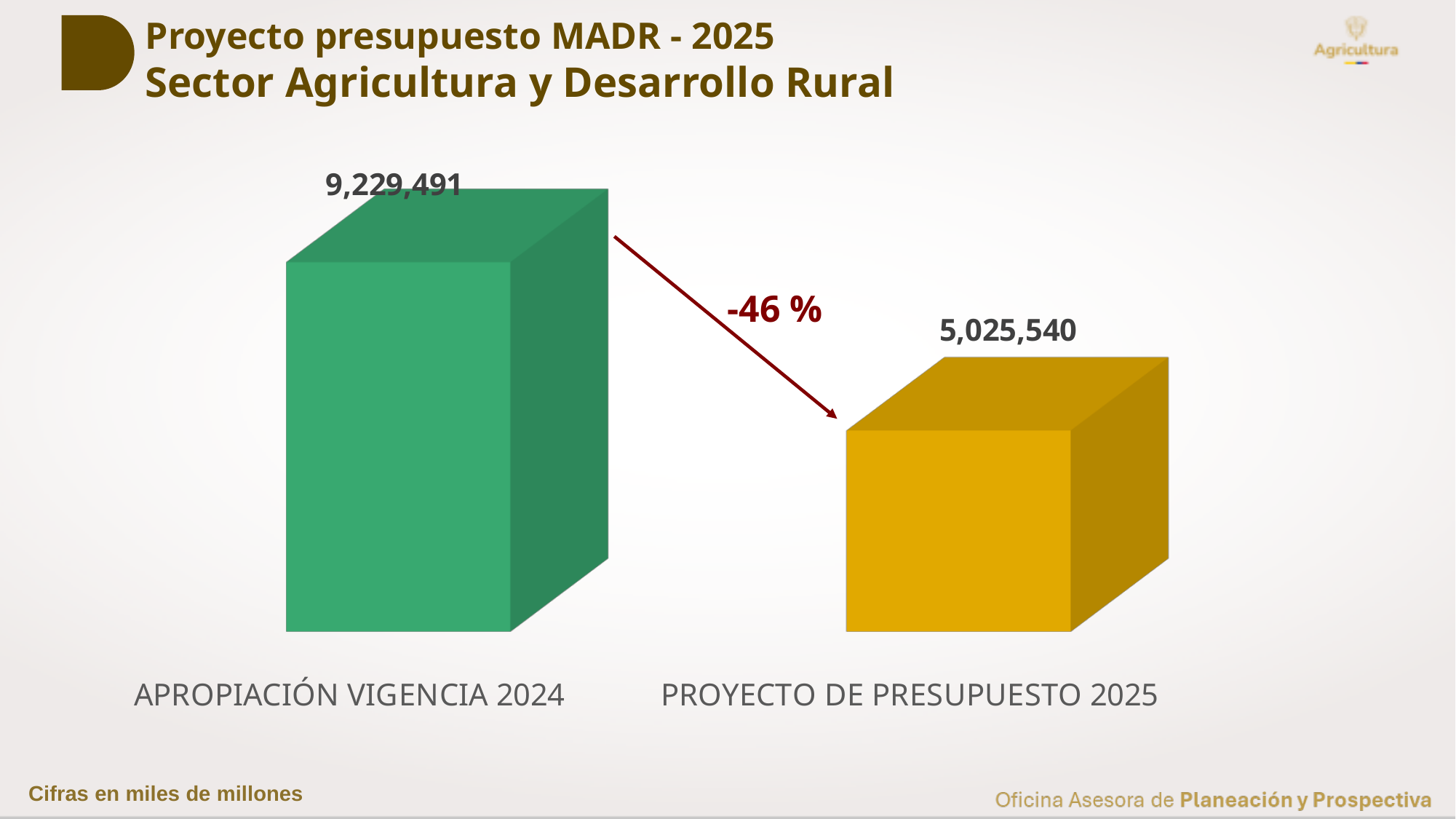
Which category has the highest value? APROPIACIÓN VIGENCIA 2024 Do the values rise or fall from APROPIACIÓN VIGENCIA 2024 to PROYECTO DE PRESUPUESTO 2025? Fall What percentage change is annotated on the arrow between the two bars? -46 % How many categories are shown in the chart? 2 What colour is the bar for PROYECTO DE PRESUPUESTO 2025? Yellow What is the difference between the value for APROPIACIÓN VIGENCIA 2024 and the value for PROYECTO DE PRESUPUESTO 2025? 4,203,951 What is the value for PROYECTO DE PRESUPUESTO 2025? 5,025,540 What is the value for APROPIACIÓN VIGENCIA 2024? 9,229,491 What kind of chart is shown on the slide? Bar chart Which category has the lowest value? PROYECTO DE PRESUPUESTO 2025 Which is larger, the value for APROPIACIÓN VIGENCIA 2024 or the value for PROYECTO DE PRESUPUESTO 2025? APROPIACIÓN VIGENCIA 2024